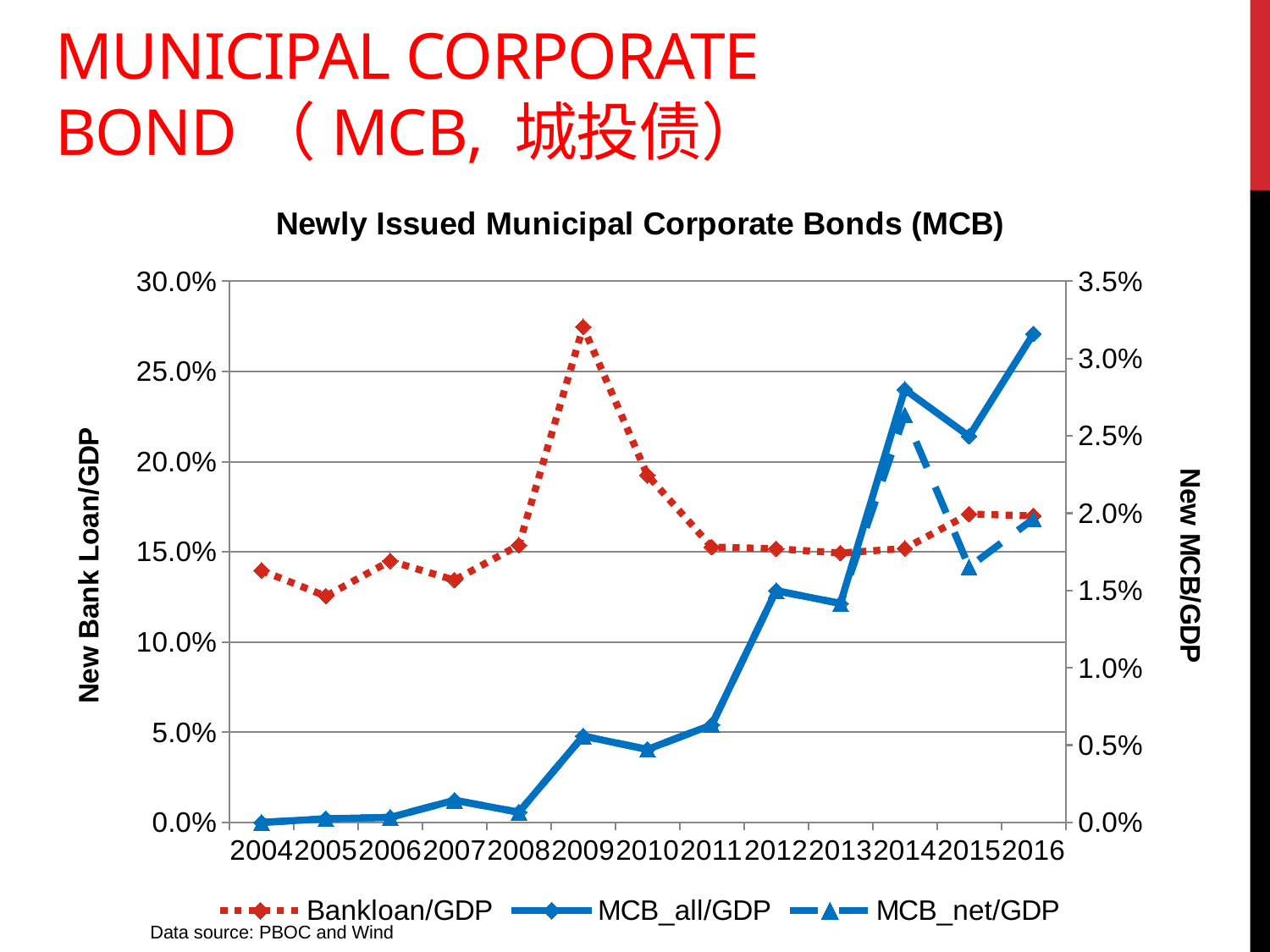
How many series does the legend list? 3 In which year is MCB_all/GDP highest? 2016 What kind of chart is shown on the slide? Line chart In which year is Bankloan/GDP highest? 2009 In which year is MCB_all/GDP lowest? 2004 Which is larger, MCB_all/GDP in 2014 or MCB_all/GDP in 2015? 2014 How many years are plotted along the x axis? 13 Does MCB_all/GDP generally rise or fall from 2004 to 2016? Rise Is the value for MCB_all/GDP in 2016 greater or less than 3.0%? greater Is the value for Bankloan/GDP in 2009 greater or less than 25.0%? greater Is the value for Bankloan/GDP in 2005 greater or less than 15.0%? less What is the title of the right-hand vertical axis? New MCB/GDP